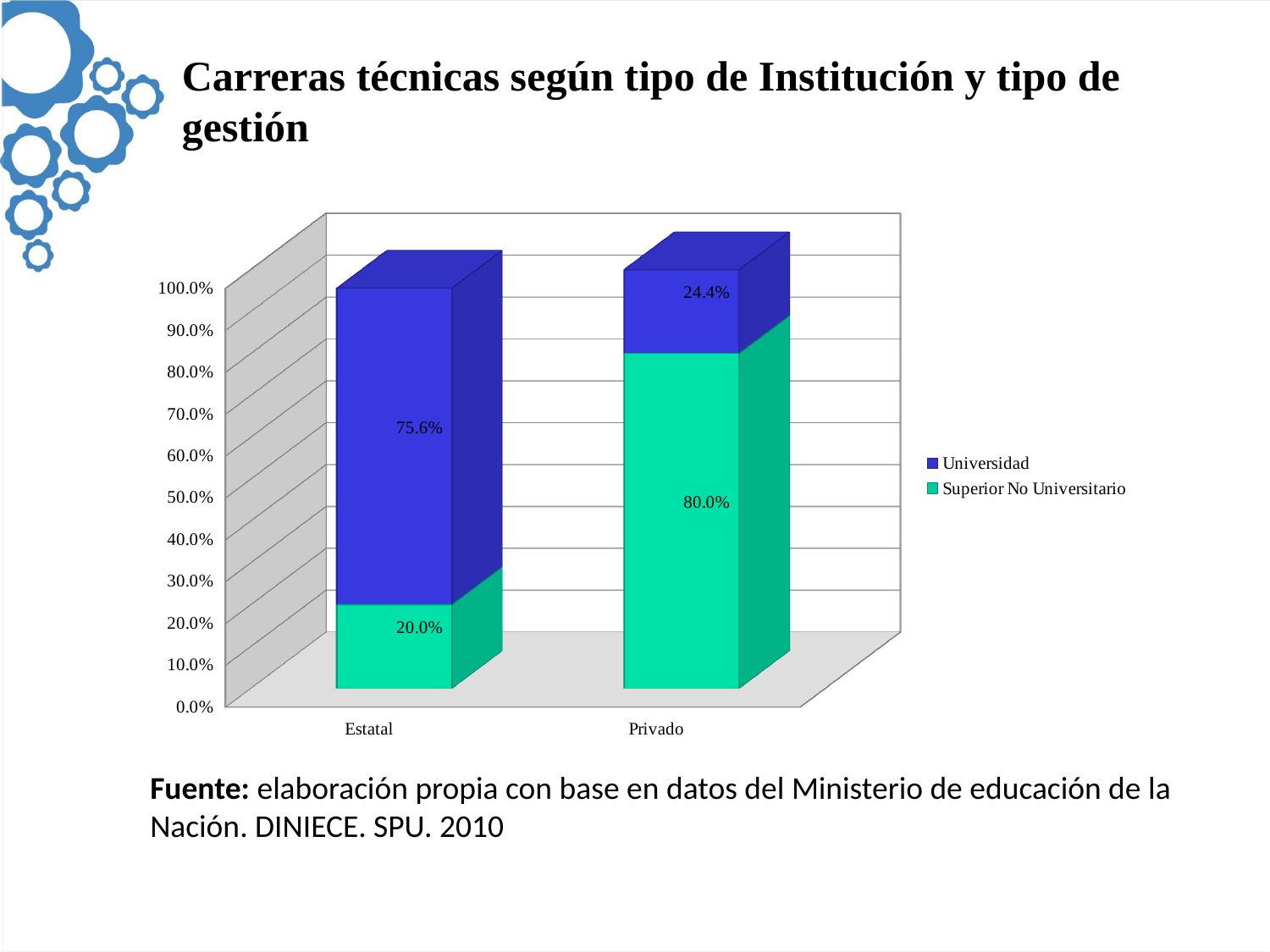
What is the value for Superior No Universitario in the Privado bar? 80.0% What is the value for Universidad in the Estatal bar? 75.6% What is the value for Superior No Universitario in the Estatal bar? 20.0% Which series is shown in green in the legend? Superior No Universitario How many series does the legend list? 2 Which category has the higher value for Universidad, Estatal or Privado? Estatal What is the difference between the Universidad values for Estatal and Privado? 51.2% What is the difference between the Superior No Universitario values for Privado and Estatal? 60.0% Which category has the lower value for Superior No Universitario? Estatal What kind of chart is shown on the slide? Stacked bar chart How many categories are shown on the x axis? 2 What is the value for Universidad in the Privado bar? 24.4%